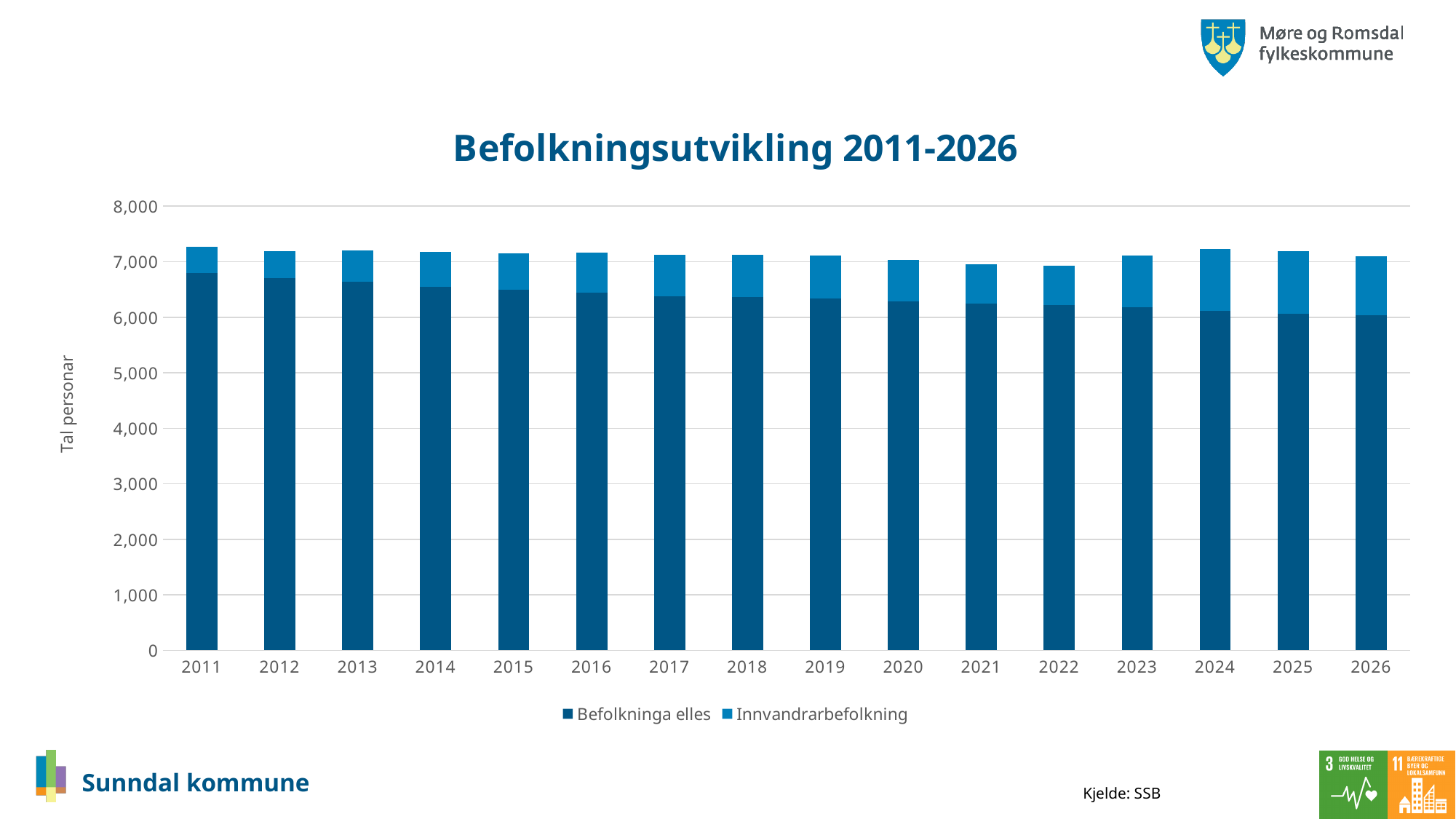
What is the title of the chart? Befolkningsutvikling 2011-2026 Is the value for Befolkninga elles in 2011 greater or less than 7,000? less What kind of chart is shown on the slide? Bar chart How many years are shown on the x axis? 16 Is the value for Befolkninga elles in 2026 greater or less than 7,000? less How many series does the legend list? 2 Is the value for Befolkninga elles in 2011 greater or less than 6,000? greater Which is larger, the Innvandrarbefolkning value for 2011 or for 2026? 2026 Does the Befolkninga elles series rise or fall from 2011 to 2026? Fall What is the label on the vertical axis? Tal personar Which year has the highest value for Befolkninga elles? 2011